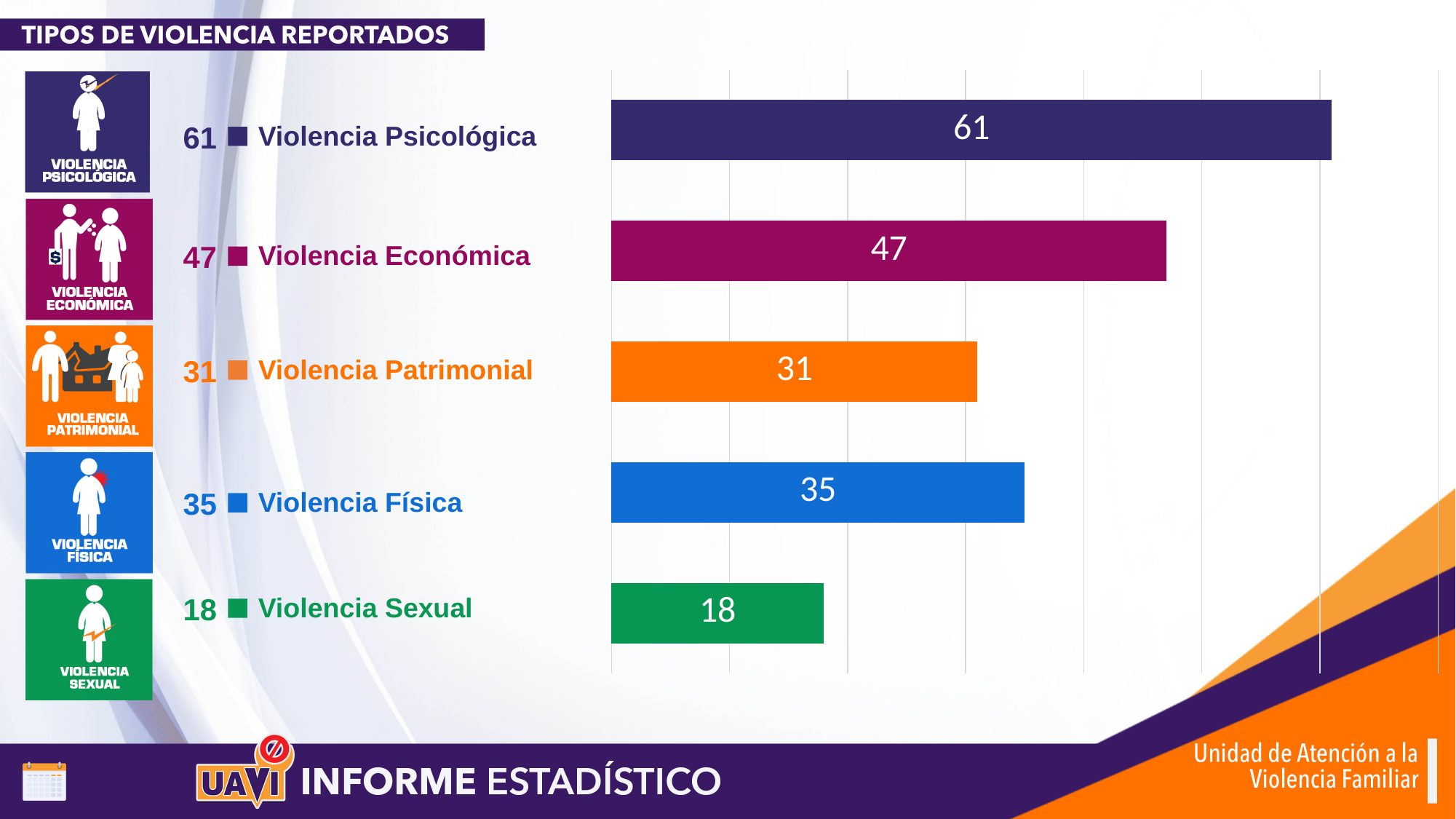
Which is larger, the value for Violencia Física or Violencia Patrimonial? Violencia Física What kind of chart is shown on the slide? Bar chart Which type of violence has the lowest reported value? Violencia Sexual What value is shown for Violencia Psicológica? 61 What is the title of the slide's chart? TIPOS DE VIOLENCIA REPORTADOS What value is shown for Violencia Sexual? 18 What is the difference between the values for Violencia Psicológica and Violencia Económica? 14 Which type of violence has the highest reported value? Violencia Psicológica How many types of violence are plotted in the chart? 5 What value is shown for Violencia Patrimonial? 31 What value is shown for Violencia Económica? 47 What value is shown for Violencia Física? 35